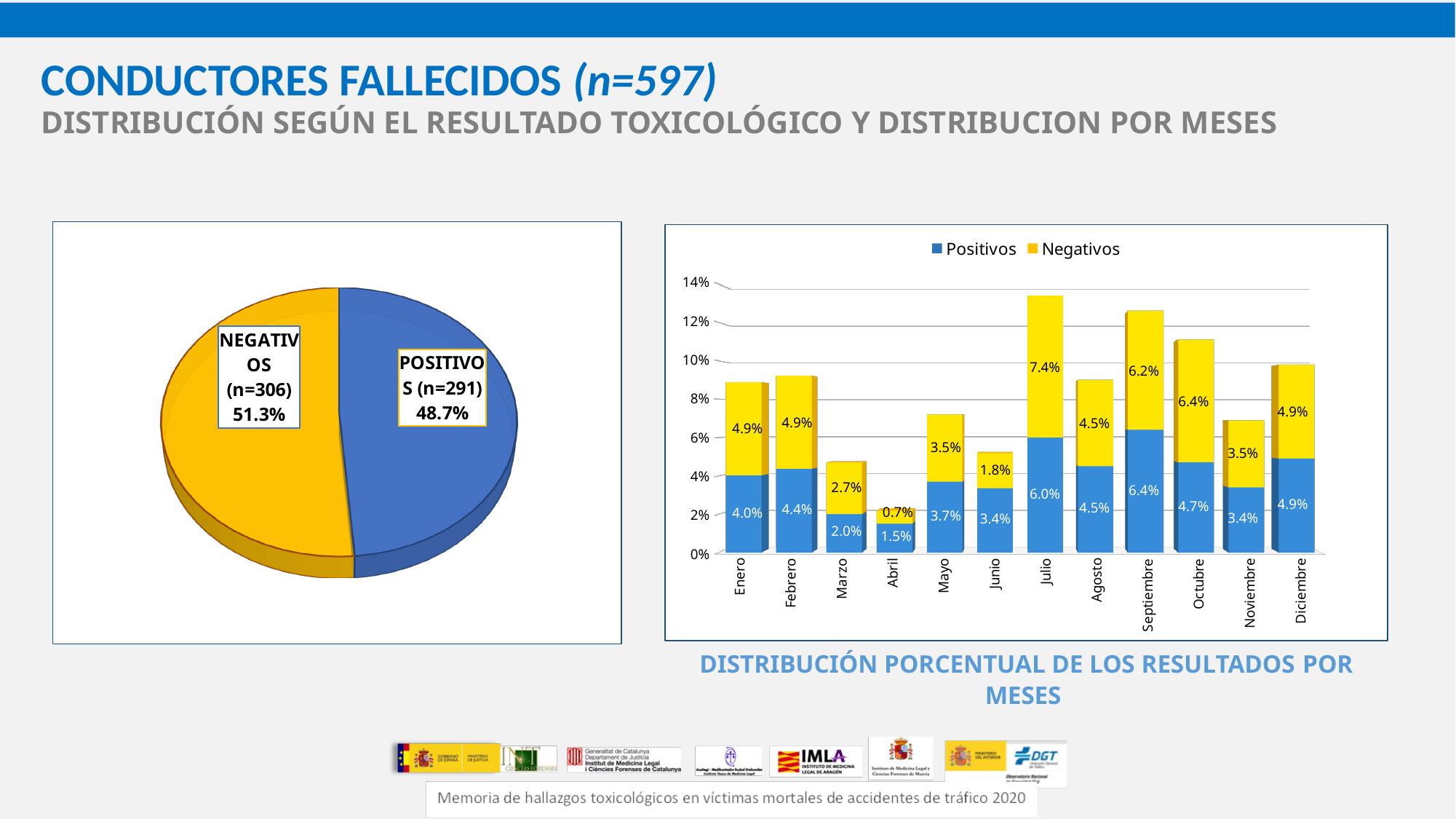
In the pie chart on the left, what share of the pie is NEGATIVOS? 51.3% In the chart 'DISTRIBUCIÓN PORCENTUAL DE LOS RESULTADOS POR MESES', what is the total of the stacked bar for Julio? 13.4% In the chart 'DISTRIBUCIÓN PORCENTUAL DE LOS RESULTADOS POR MESES', what is the Positivos value for Julio? 6.0% In the chart 'DISTRIBUCIÓN PORCENTUAL DE LOS RESULTADOS POR MESES', what is the difference between the Negativos and Positivos values for Julio? 1.4% In the chart 'DISTRIBUCIÓN PORCENTUAL DE LOS RESULTADOS POR MESES', which is larger for Marzo: Positivos or Negativos? Negativos In the chart 'DISTRIBUCIÓN PORCENTUAL DE LOS RESULTADOS POR MESES', how many months are shown on the x axis? 12 In the chart 'DISTRIBUCIÓN PORCENTUAL DE LOS RESULTADOS POR MESES', how many series does the legend list? 2 In the pie chart on the left, what is the n value shown for POSITIVOS? n=291 In the chart 'DISTRIBUCIÓN PORCENTUAL DE LOS RESULTADOS POR MESES', what is the Negativos value for Octubre? 6.4% In the chart 'DISTRIBUCIÓN PORCENTUAL DE LOS RESULTADOS POR MESES', which month has the highest Positivos value? Septiembre In the chart 'DISTRIBUCIÓN PORCENTUAL DE LOS RESULTADOS POR MESES', which month has the lowest Negativos value? Abril What kind of chart is the chart on the left of the slide? Pie chart